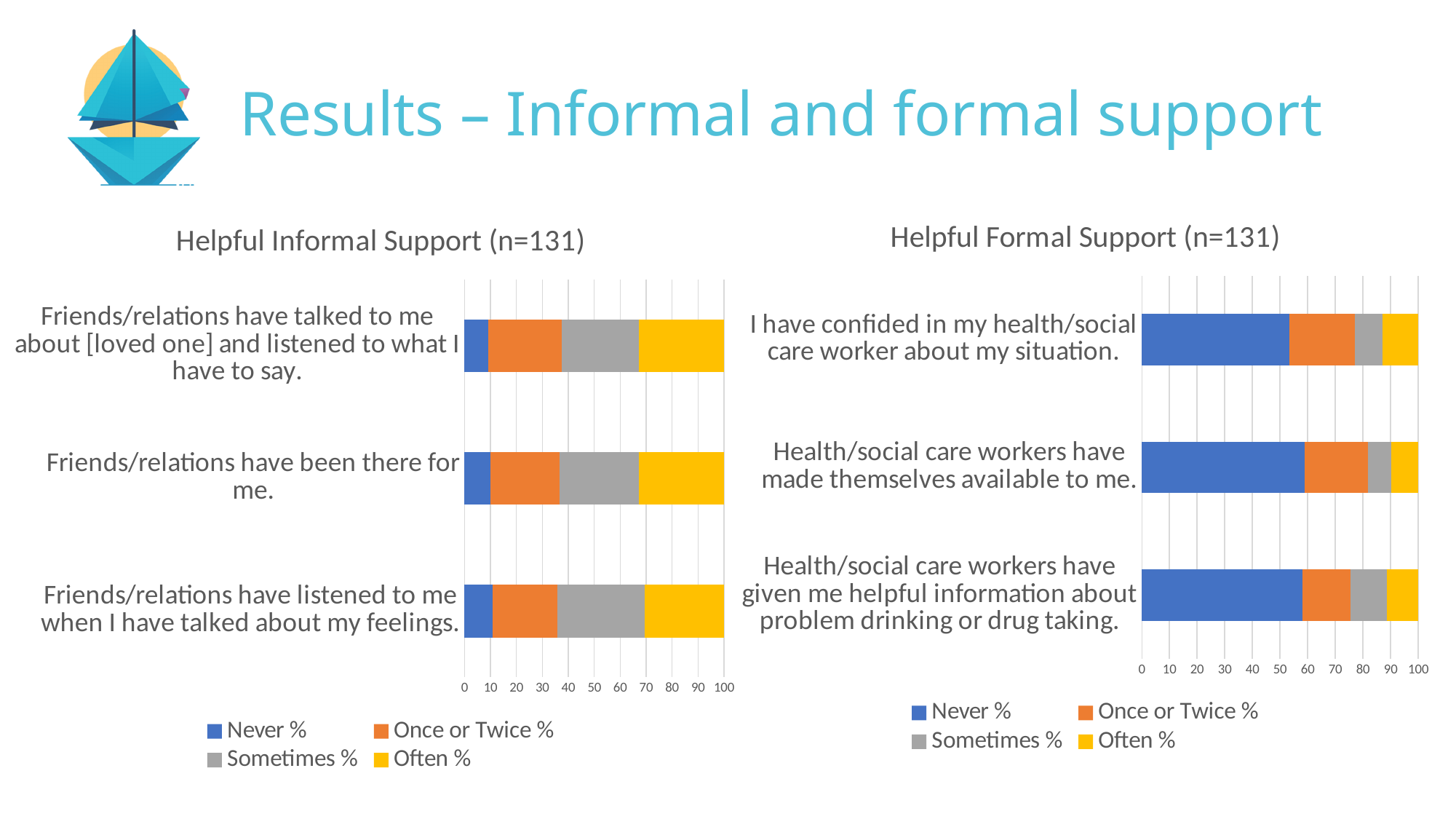
In the Helpful Formal Support (n=131) chart, which response category has the largest share for "Health/social care workers have given me helpful information about problem drinking or drug taking."? Never % In the Helpful Formal Support (n=131) chart, is the Never % value for "I have confided in my health/social care worker about my situation." greater or less than 40? greater In the Helpful Informal Support (n=131) chart, is the Often % value for "Friends/relations have listened to me when I have talked about my feelings." greater or less than 20? greater What kind of chart is the Helpful Informal Support (n=131) chart? stacked bar chart What is the title of the chart on the left of the slide? Helpful Informal Support (n=131) How many statements (categories) are shown in the Helpful Formal Support (n=131) chart? 3 In the Helpful Informal Support (n=131) chart, is the Never % value for "Friends/relations have been there for me." greater or less than 20? less How many series does the legend of the Helpful Informal Support (n=131) chart list? 4 Which is larger: the Often % for "Friends/relations have listened to me when I have talked about my feelings." in the Helpful Informal Support chart, or the Often % for "I have confided in my health/social care worker about my situation." in the Helpful Formal Support chart? Friends/relations have listened to me when I have talked about my feelings. Which is larger: the Never % for "Friends/relations have been there for me." in the Helpful Informal Support chart, or the Never % for "Health/social care workers have made themselves available to me." in the Helpful Formal Support chart? Health/social care workers have made themselves available to me. In the Helpful Formal Support (n=131) chart, which response category is listed first in the legend? Never %